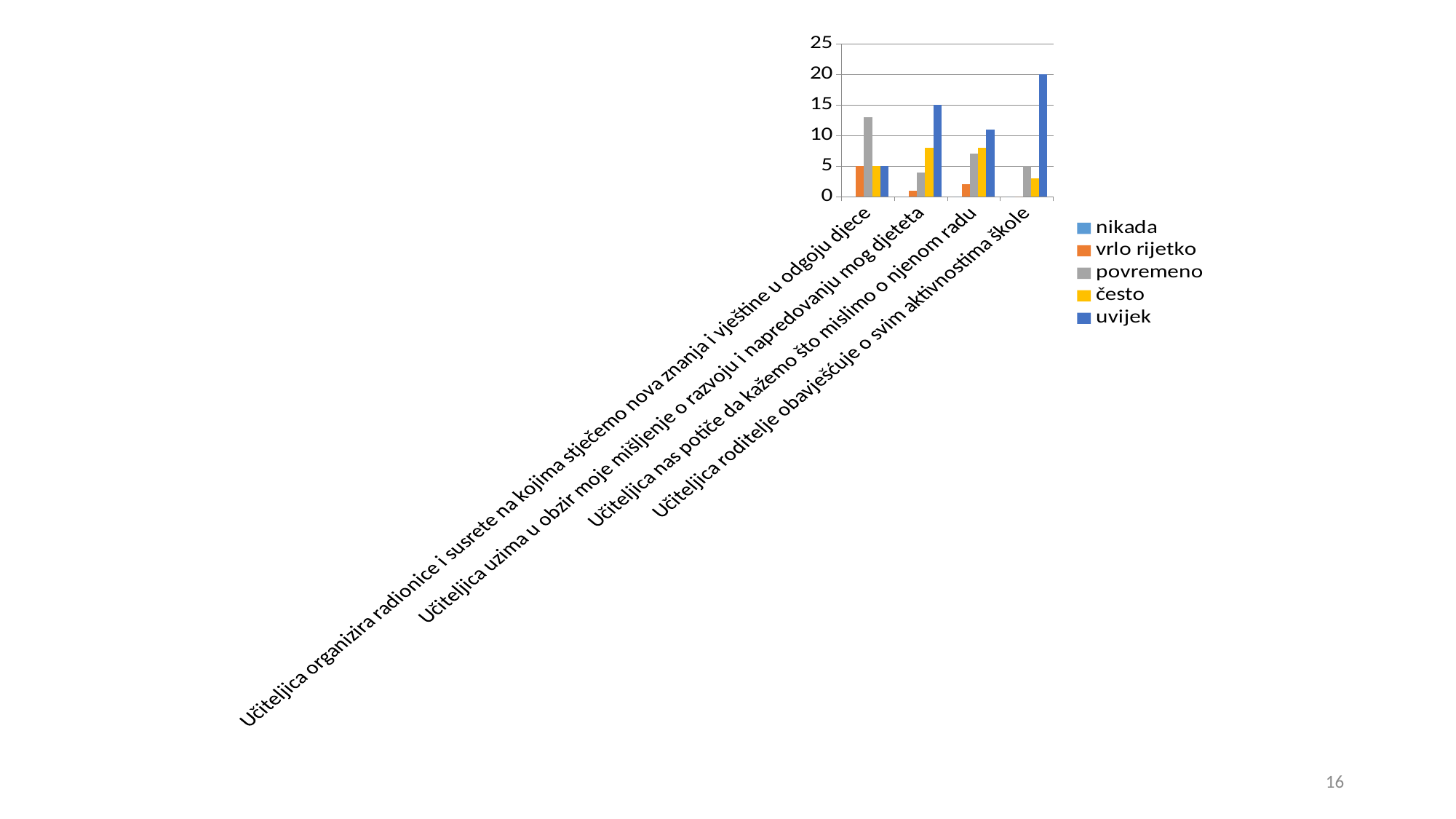
Which series is listed first in the legend? nikada What is the value of 'uvijek' for 'Učiteljica roditelje obavješćuje o svim aktivnostima škole'? 20 For which category is the 'uvijek' bar highest? Učiteljica roditelje obavješćuje o svim aktivnostima škole Is the 'uvijek' value for 'Učiteljica nas potiče da kažemo što mislimo o njenom radu' greater or less than 10? greater What is the value of 'uvijek' for 'Učiteljica uzima u obzir moje mišljenje o razvoju i napredovanju mog djeteta'? 15 Is the 'povremeno' value for 'Učiteljica organizira radionice i susrete na kojima stječemo nova znanja i vještine u odgoju djece' greater or less than 10? greater What kind of chart is shown on the slide? bar chart How many categories are shown on the x axis? 4 How many series does the legend list? 5 Which is larger: the 'uvijek' value for 'Učiteljica uzima u obzir moje mišljenje o razvoju i napredovanju mog djeteta' or for 'Učiteljica nas potiče da kažemo što mislimo o njenom radu'? Učiteljica uzima u obzir moje mišljenje o razvoju i napredovanju mog djeteta Is the 'često' value for 'Učiteljica uzima u obzir moje mišljenje o razvoju i napredovanju mog djeteta' greater or less than 10? less For which category is the 'uvijek' bar lowest? Učiteljica organizira radionice i susrete na kojima stječemo nova znanja i vještine u odgoju djece